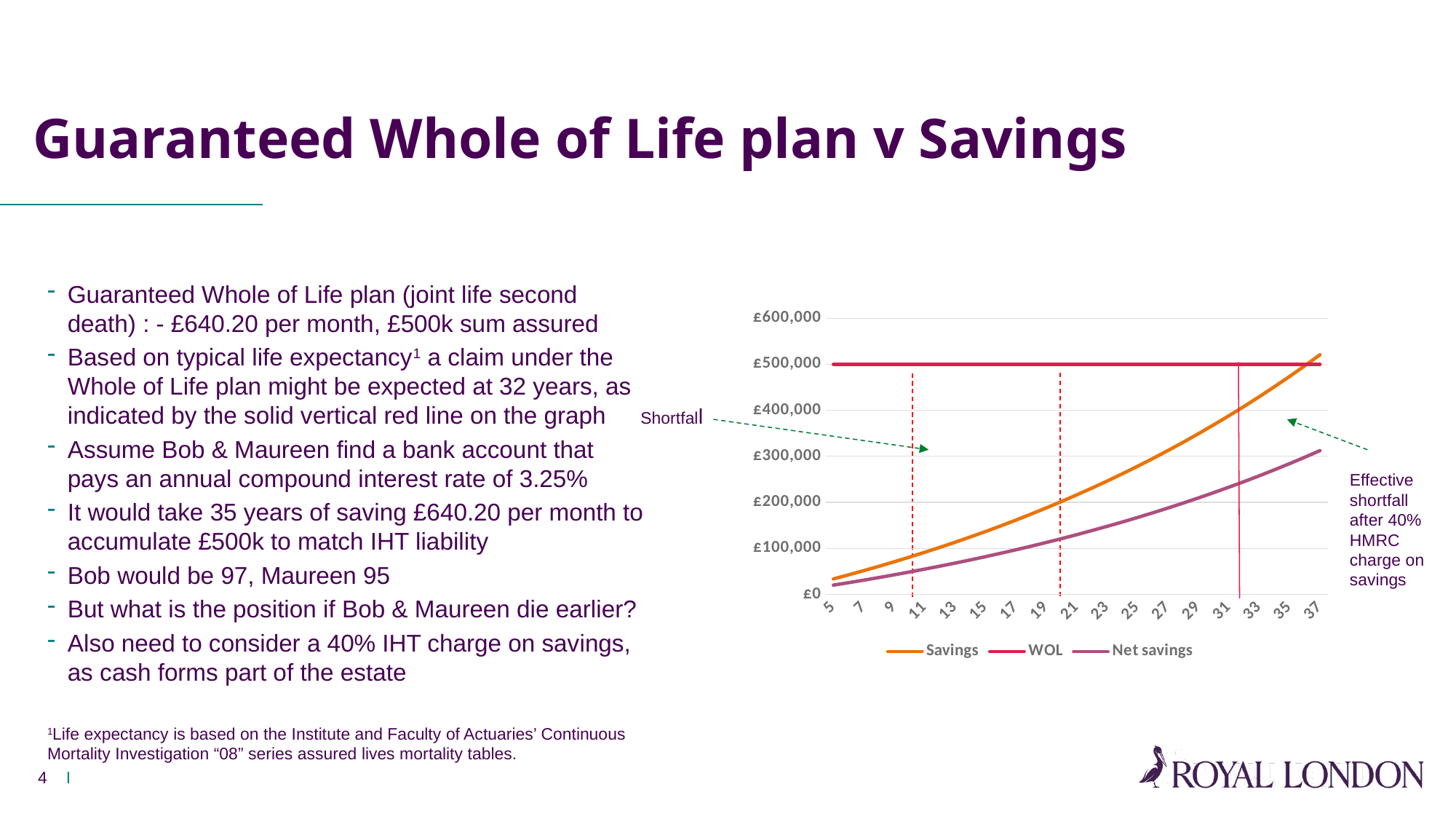
Do the Savings values rise or fall as the years increase along the x axis? rise What kind of chart is shown on the slide? line chart How many year labels are shown on the x axis of the chart? 17 What are the three series named in the chart legend? Savings, WOL, Net savings Is the Net savings value at year 37 greater or less than £400,000? less Which series has the highest value at year 5? WOL What value does the flat WOL line sit at on the chart? £500,000 At year 29, which is larger: Savings or Net savings? Savings How many series does the chart legend list? 3 Is the Savings value at year 21 greater or less than £300,000? less Do the Net savings values rise or fall along the x axis? rise What colour is the WOL line on the chart? red